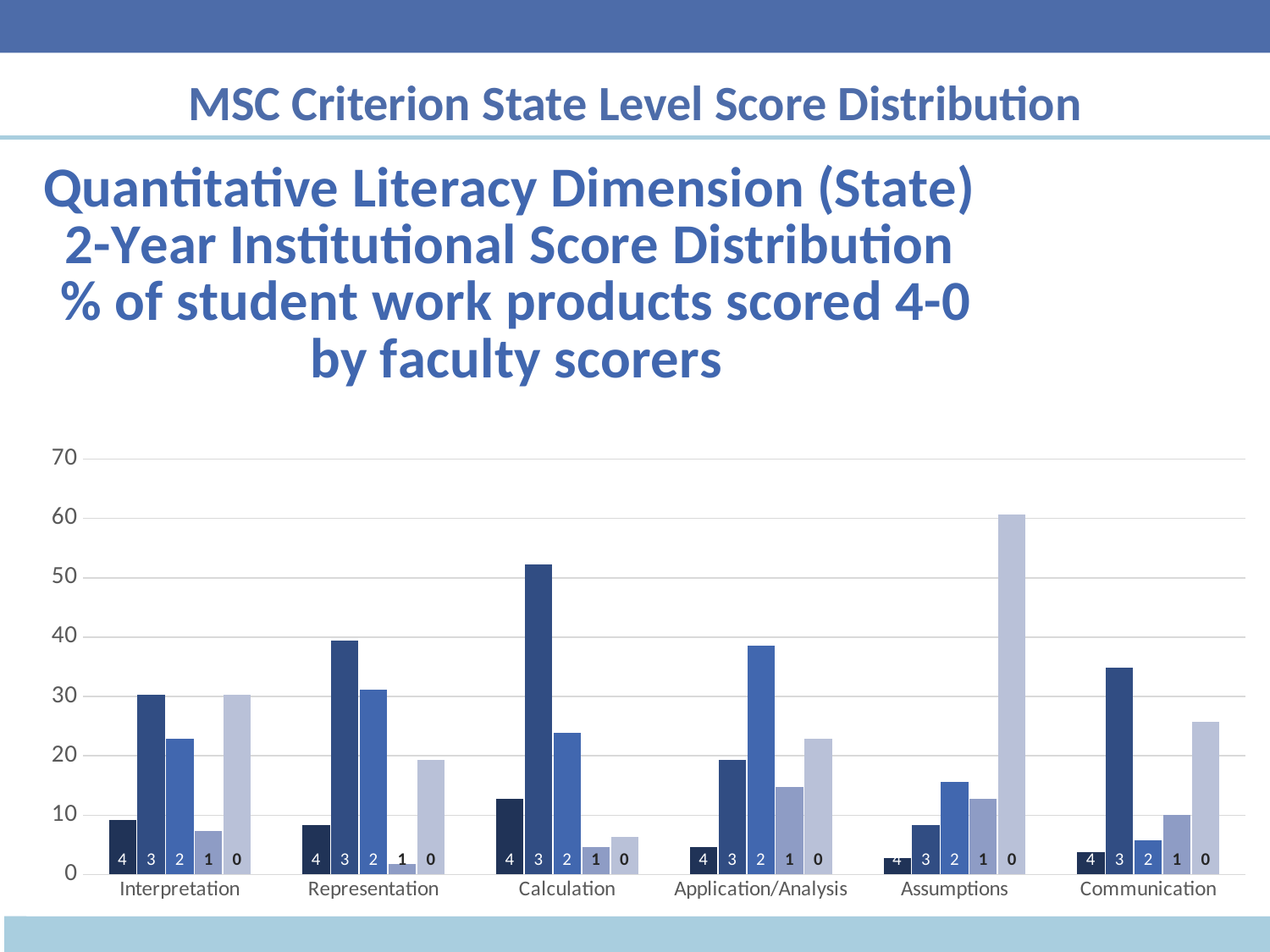
Within the Assumptions category, which score level has the highest bar? 0 Within the Representation category, which score level has the lowest bar? 1 How many criterion categories are shown along the x axis? 6 Within the Application/Analysis category, which score level has the highest bar? 2 Within the Calculation category, which score level has the highest bar? 3 Is the value for score 0 in Assumptions greater or less than 50? greater Is the value for score 3 in Calculation greater or less than 50? greater Which is larger: the score 3 bar for Calculation or the score 3 bar for Representation? Calculation How many bars (score levels) are plotted for each category? 5 Is the value for score 4 in Interpretation greater or less than 20? less What kind of chart is shown on the slide? bar chart